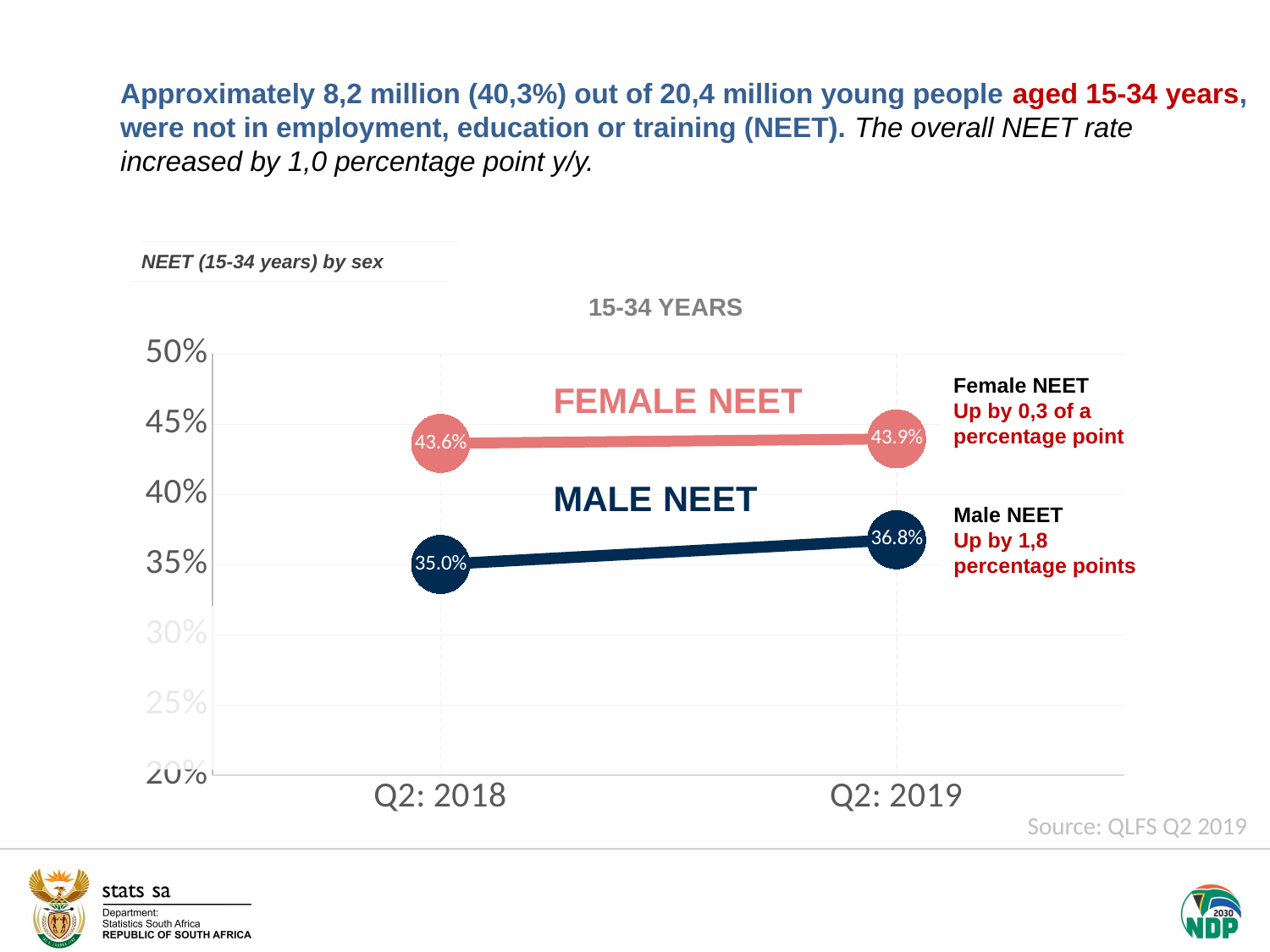
How many time periods are shown on the x axis? 2 Is the Male NEET rate in Q2: 2018 greater or less than 40%? less What type of chart is shown on the slide? Line chart What is the Female NEET rate in Q2: 2018? 43.6% What is the Male NEET rate in Q2: 2019? 36.8% Which series has the higher value in Q2: 2019, Female NEET or Male NEET? Female NEET What is the difference between the Female NEET rate and the Male NEET rate in Q2: 2018? 8.6 percentage points Does the Male NEET rate rise or fall from Q2: 2018 to Q2: 2019? Rise What is the Male NEET rate in Q2: 2018? 35.0% By how many percentage points did the Male NEET rate change from Q2: 2018 to Q2: 2019? 1.8 percentage points What is the Female NEET rate in Q2: 2019? 43.9% How many series are plotted on the chart? 2